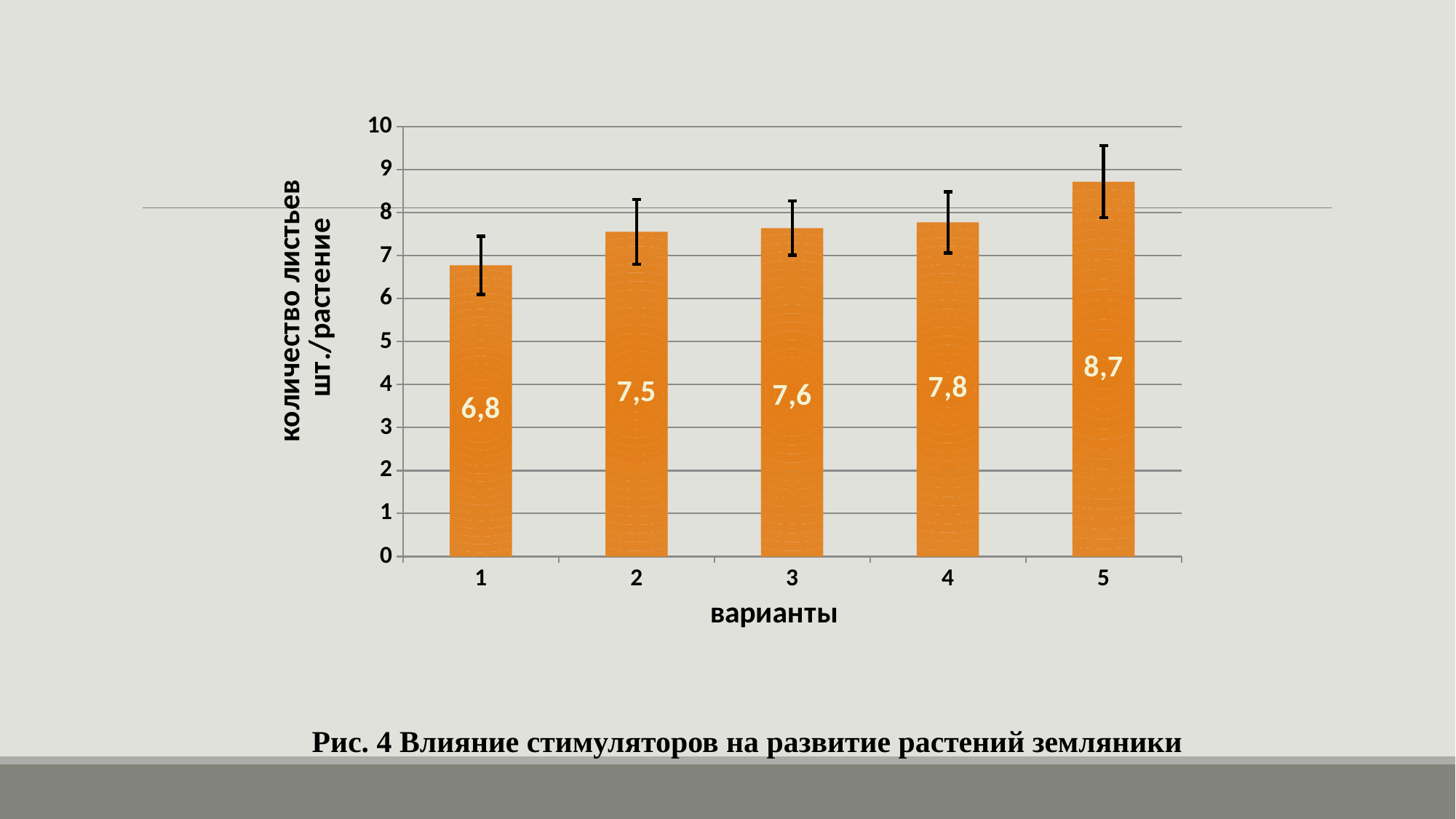
What is the value for variant 1? 6,8 What is the value for variant 5? 8,7 What is the value for variant 3? 7,6 Which variant has the lowest number of leaves per plant? 1 What kind of chart is shown on the slide? bar chart What is the label of the x axis? варианты What is the difference between the values for variant 5 and variant 1? 1,9 Do the values rise or fall from variant 1 to variant 5? rise How many variants are shown on the x axis? 5 Which variant has the highest number of leaves per plant? 5 Is the value for variant 5 greater or less than 8? greater Which is larger, the value for variant 2 or variant 4? variant 4